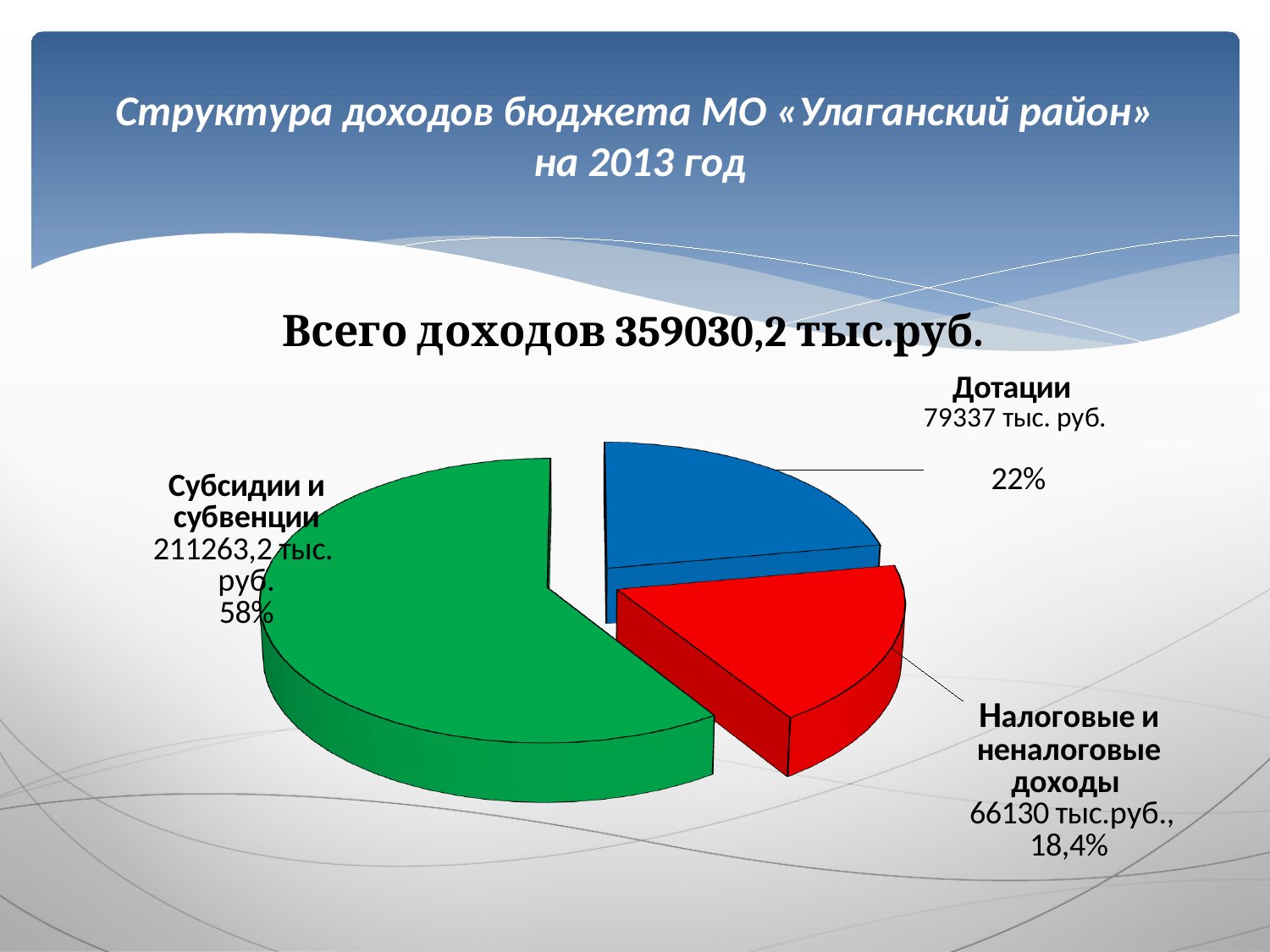
What is the value for Субсидии и субвенции? 211263,2 тыс. руб. How many slices does the pie chart have? 3 What is the value for Налоговые и неналоговые доходы? 66130 тыс.руб. What is the value for Дотации? 79337 тыс. руб. What is the title of the chart? Всего доходов 359030,2 тыс.руб. What kind of chart is shown on the slide? Pie chart Which colour is the slice for Дотации? Blue Which category has the smallest slice? Налоговые и неналоговые доходы What share of the pie does Субсидии и субвенции represent? 58% What share of the pie does Налоговые и неналоговые доходы represent? 18,4% Which category has the largest slice? Субсидии и субвенции What is the difference between Дотации and Налоговые и неналоговые доходы? 13207 тыс. руб.